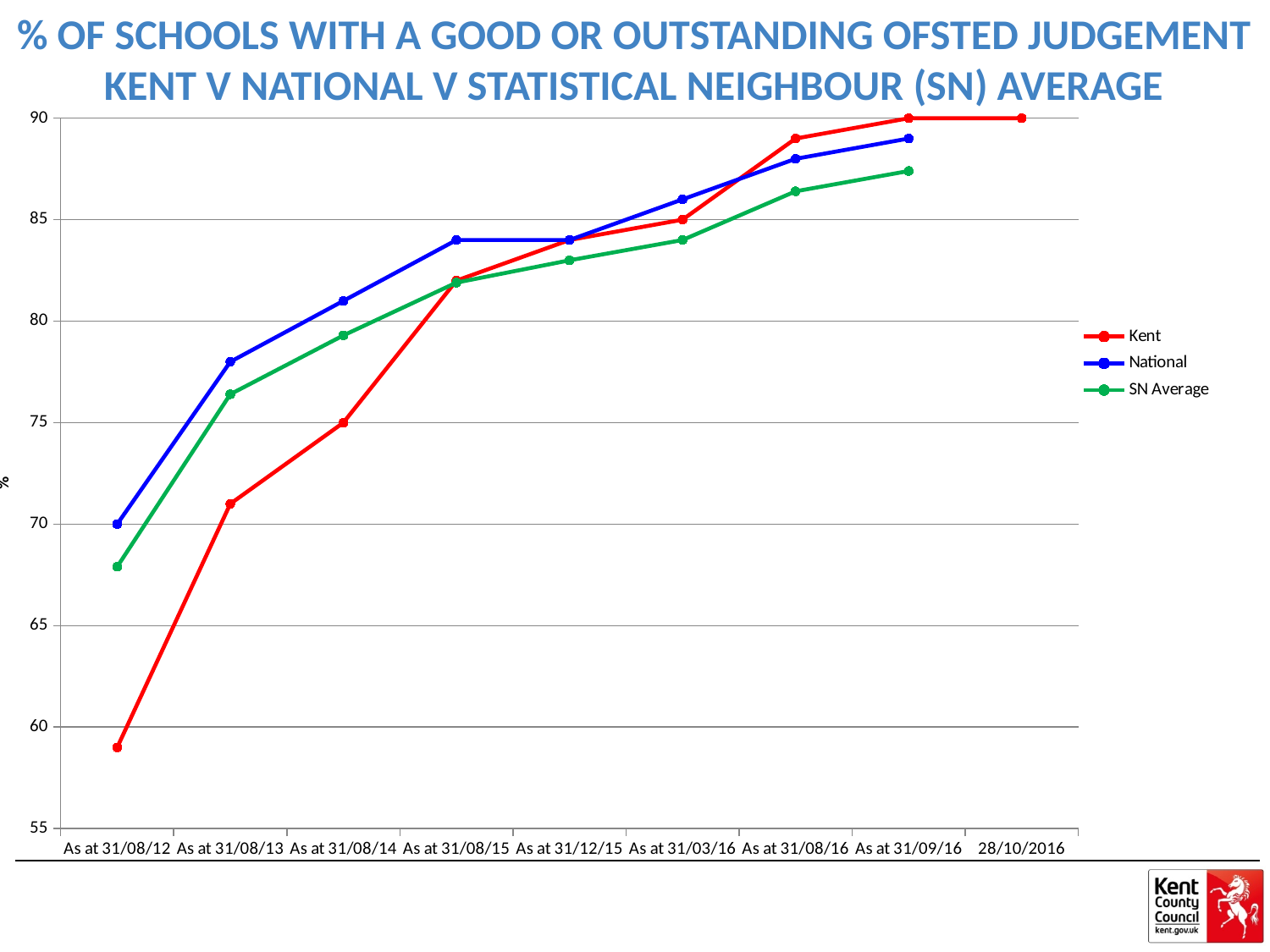
Is the value for SN Average as at 31/08/12 greater or less than 70? less What kind of chart is shown on the slide? line chart What is the value for Kent on 28/10/2016? 90 Does the Kent line generally rise or fall across the dates on the x axis? rise Is the value for Kent as at 31/08/12 greater or less than 60? less Which series has the lowest value as at 31/08/12? Kent As at 31/08/16, which is larger, Kent or SN Average? Kent What is the value for National as at 31/08/12? 70 Is the value for National as at 31/08/16 greater or less than 85? greater How many series does the legend list? 3 What is the value for Kent as at 31/08/14? 75 How many dates are shown along the x axis? 9